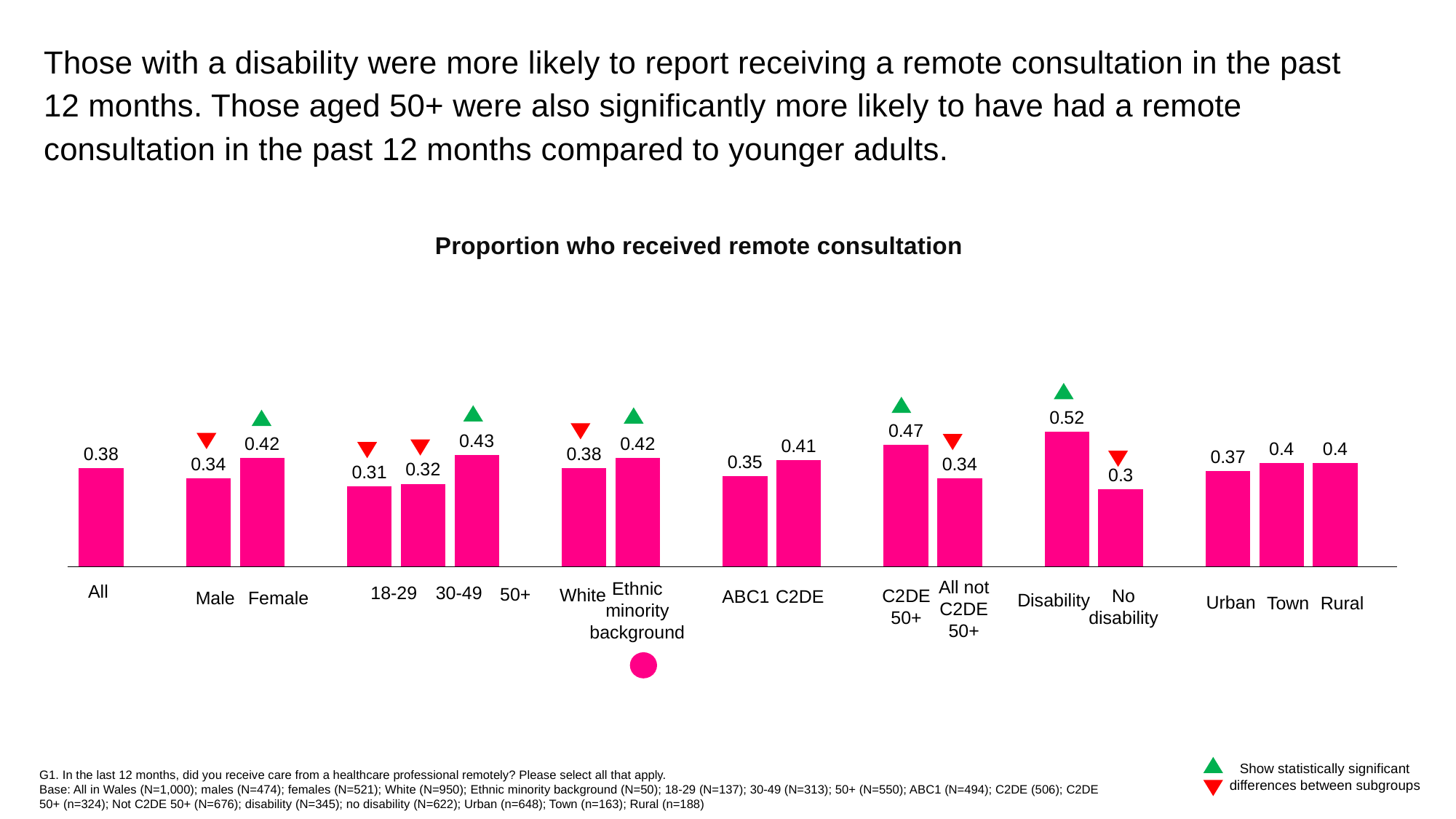
What is the value for 18-29? 0.31 What is the value for Disability? 0.52 Which is larger, the value for 50+ or the value for 30-49? 50+ What is the title of the chart? Proportion who received remote consultation Which category has the lowest value? No disability What is the value for C2DE 50+? 0.47 What is the value for the All category? 0.38 How many bars are plotted in the chart? 17 What is the difference between the values for Female and Male? 0.08 What kind of chart is shown? Bar chart What is the difference between the values for Disability and No disability? 0.22 Which category has the highest value? Disability